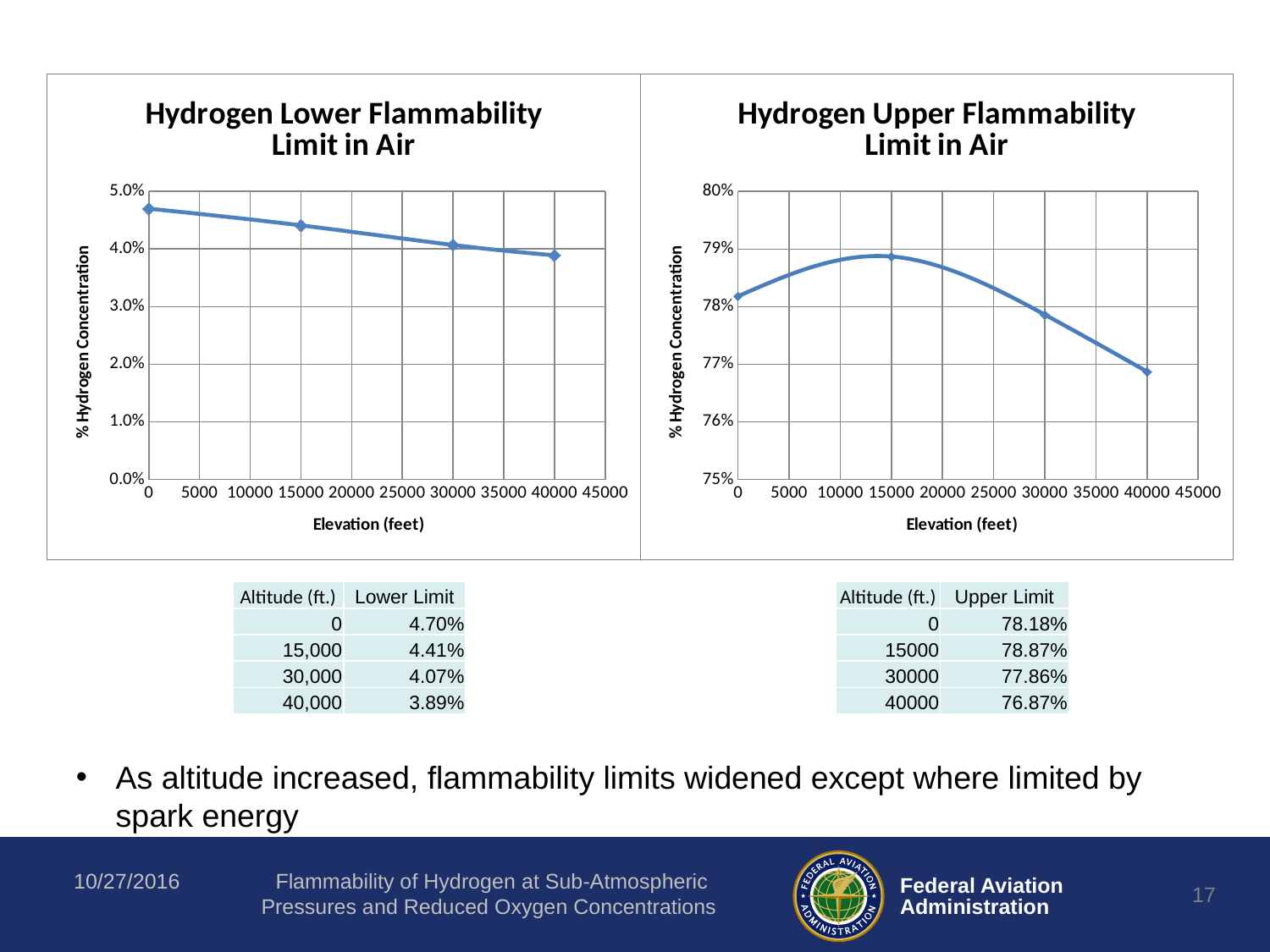
In the Hydrogen Lower Flammability Limit in Air chart, does the lower limit rise or fall as elevation increases? fall What kind of chart is the Hydrogen Lower Flammability Limit in Air chart? line chart In the Hydrogen Upper Flammability Limit in Air chart, what is the upper limit at 15000 ft? 78.87% How many data points are plotted in the Hydrogen Upper Flammability Limit in Air chart? 4 In the Hydrogen Lower Flammability Limit in Air chart, what is the lower limit at 40,000 ft? 3.89% In the Hydrogen Lower Flammability Limit in Air chart, is the value at 15,000 ft greater or less than 4.0%? greater In the Hydrogen Upper Flammability Limit in Air chart, which altitude has the larger upper limit, 0 ft or 30000 ft? 0 What is the y-axis title of the Hydrogen Upper Flammability Limit in Air chart? % Hydrogen Concentration In the Hydrogen Upper Flammability Limit in Air chart, at which altitude is the upper limit highest? 15000 In the Hydrogen Lower Flammability Limit in Air chart, what is the lower limit at an altitude of 0 ft? 4.70% In the Hydrogen Lower Flammability Limit in Air chart, at which altitude is the lower limit lowest? 40,000 In the Hydrogen Lower Flammability Limit in Air chart, what is the difference between the lower limit at 0 ft and at 40,000 ft? 0.81%